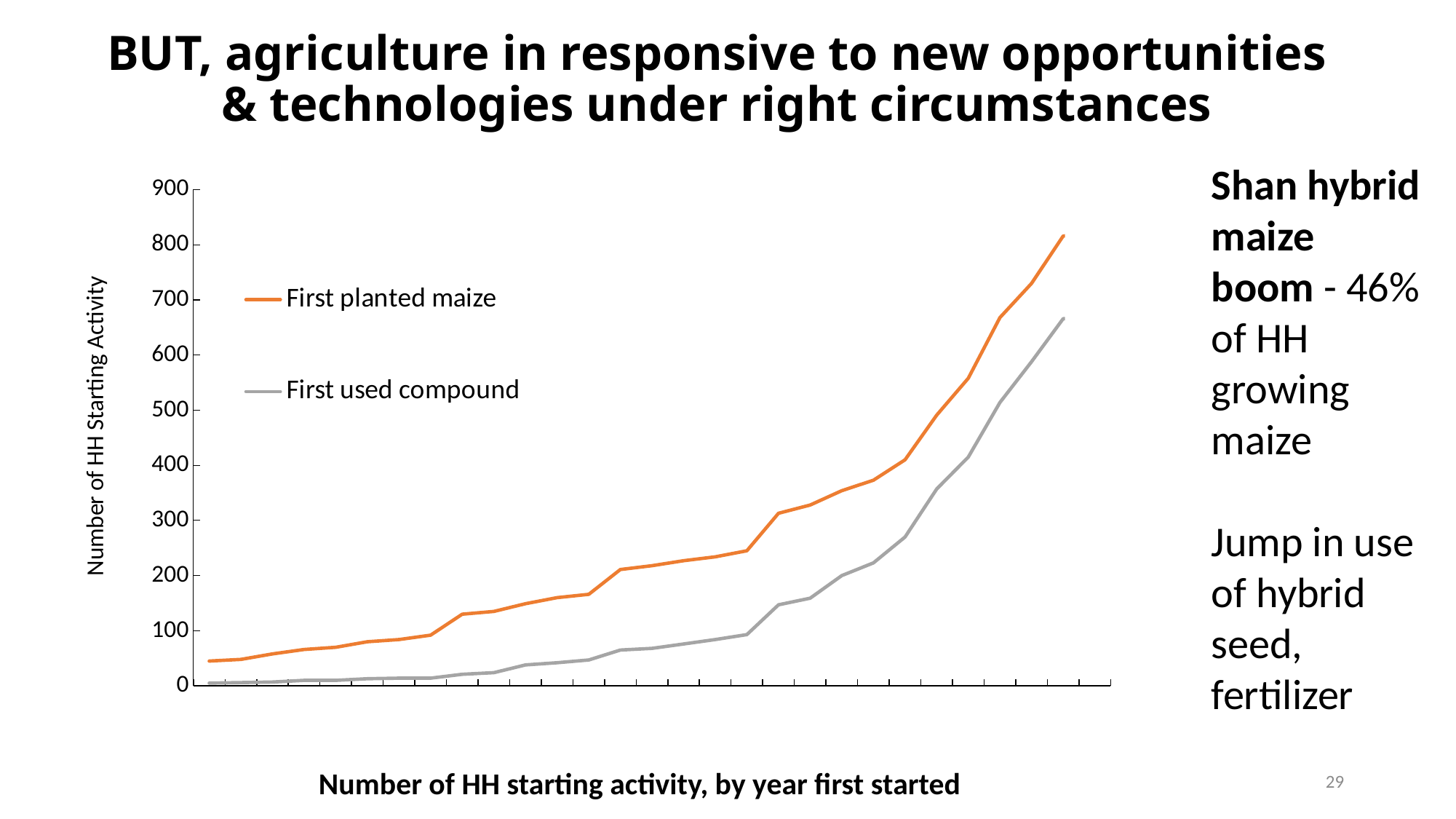
Which series has the higher maximum value on the chart? First planted maize Is the final (rightmost) value for First planted maize greater or less than 800? greater What kind of chart is shown on the slide? line chart Do the values for First planted maize rise or fall from left to right along the x axis? rise Is the final (rightmost) value for First used compound greater or less than 600? greater Is the final (rightmost) value for First used compound greater or less than 700? less Do the values for First used compound rise or fall from left to right along the x axis? rise Which series reaches the higher value at the right end of the chart, First planted maize or First used compound? First planted maize Which two series are listed in the chart's legend? First planted maize; First used compound What is the title of the chart's vertical axis? Number of HH Starting Activity How many series does the chart's legend list? 2